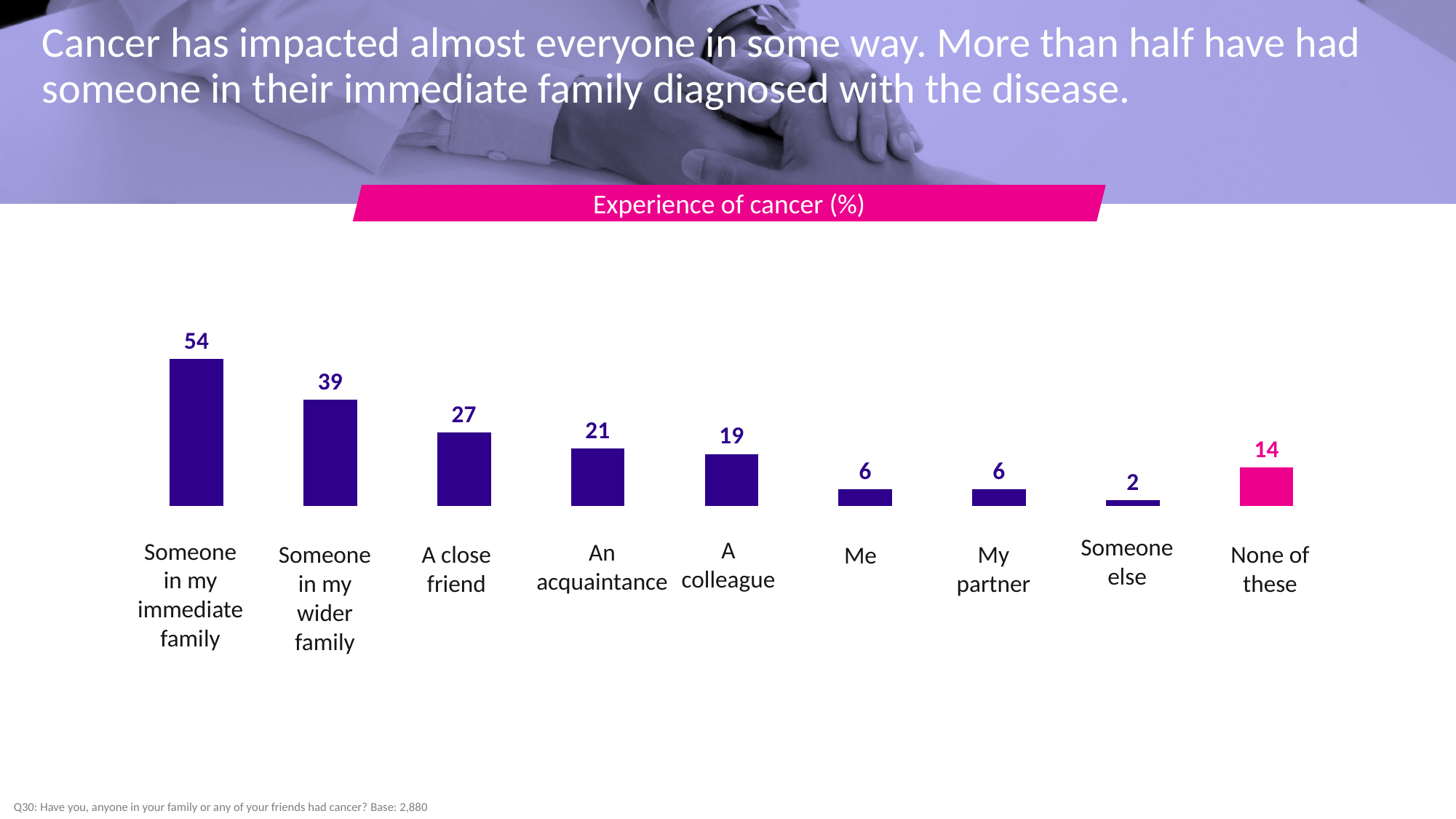
What kind of chart is shown on the slide? Bar chart How many categories are shown in the chart? 9 Which category has the lowest value? Someone else What is the value for 'My partner'? 6 What is the value for 'None of these'? 14 Which is larger, the value for 'A close friend' or the value for 'None of these'? A close friend What is the title of the chart? Experience of cancer (%) What is the difference between 'An acquaintance' and 'A colleague'? 2 Which category has the highest value? Someone in my immediate family What is the value for 'Someone in my immediate family'? 54 What is the difference between 'Someone in my immediate family' and 'Someone in my wider family'? 15 What is the value for 'A close friend'? 27